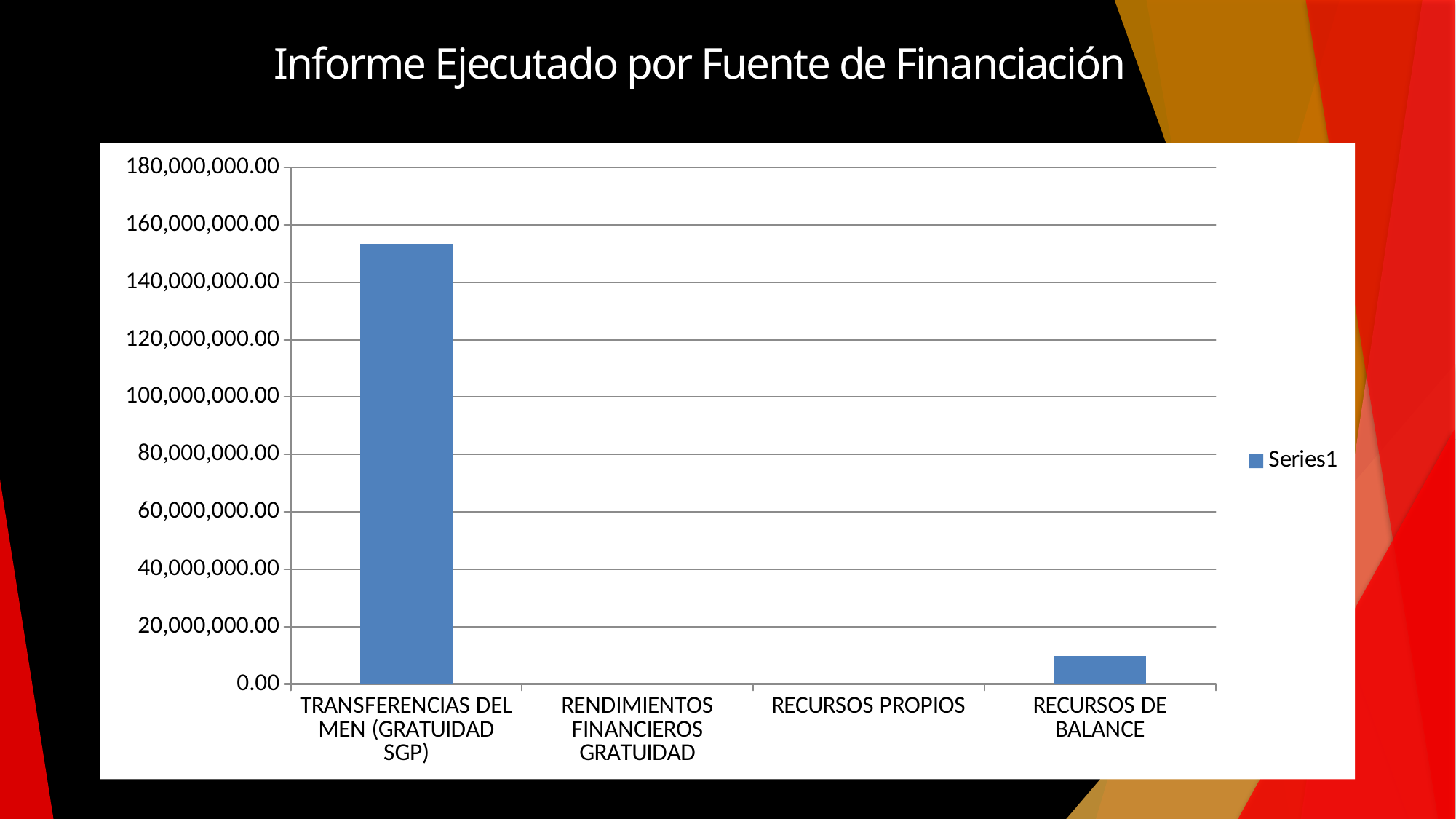
Is the value for RECURSOS DE BALANCE greater or less than 20,000,000.00? less How many series does the chart legend list? 1 What is the name of the series shown in the chart legend? Series1 What kind of chart is shown on the slide? bar chart Which is larger, the value for TRANSFERENCIAS DEL MEN (GRATUIDAD SGP) or the value for RECURSOS DE BALANCE? TRANSFERENCIAS DEL MEN (GRATUIDAD SGP) How many categories are shown on the x axis of the chart? 4 What is the title of the slide containing the chart? Informe Ejecutado por Fuente de Financiación Is the value for TRANSFERENCIAS DEL MEN (GRATUIDAD SGP) greater or less than 140,000,000.00? greater Which category has the highest value in the chart? TRANSFERENCIAS DEL MEN (GRATUIDAD SGP) Is the value for RECURSOS PROPIOS greater or less than 20,000,000.00? less